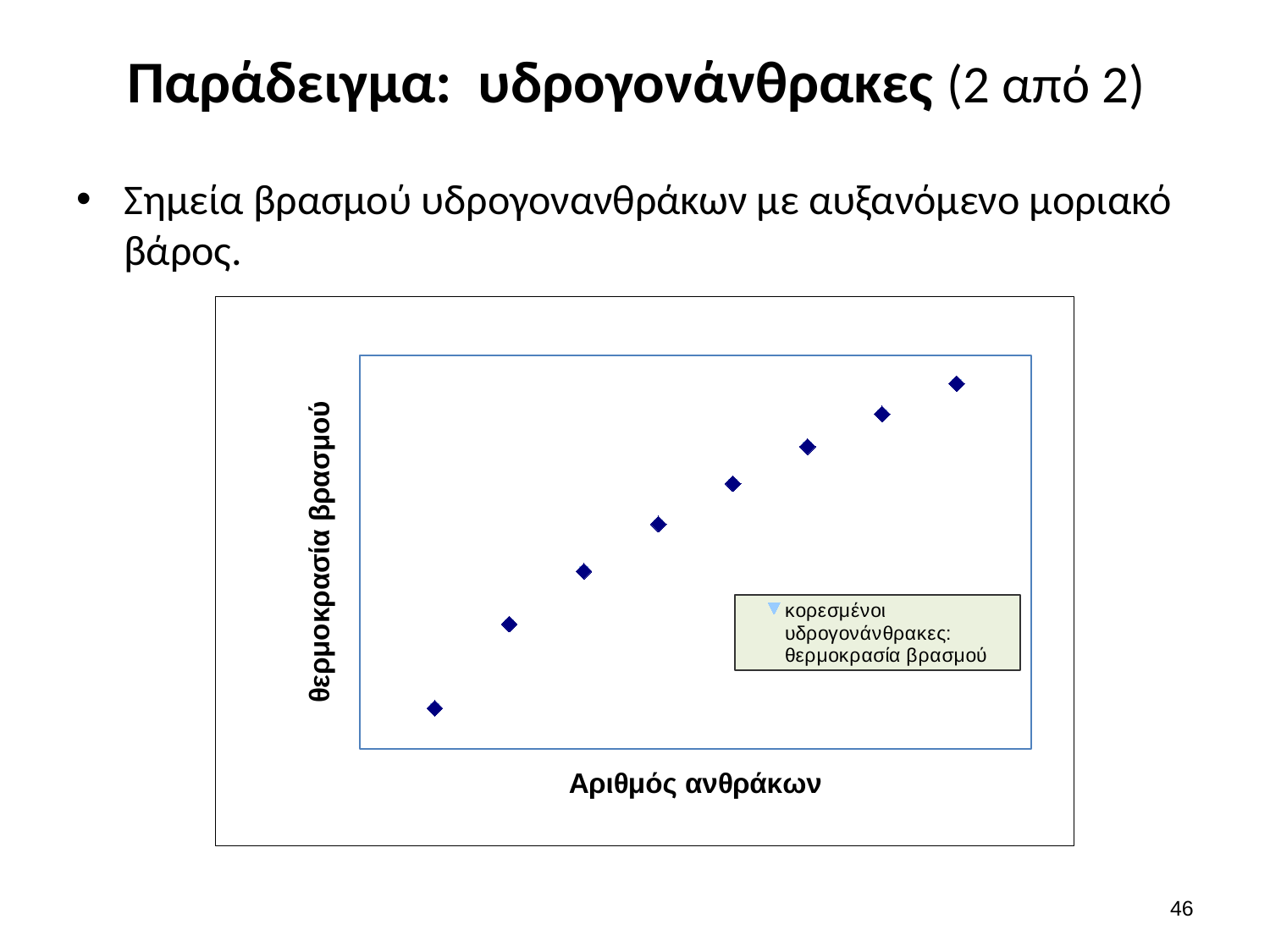
How many data points are plotted in the chart? 8 What kind of chart is shown on the slide? scatter plot Is the highest plotted boiling temperature at the leftmost or the rightmost point of the chart? rightmost Do the plotted values rise or fall as the number of carbons increases along the x axis? rise What series name does the chart legend show? κορεσμένοι υδρογονάνθρακες: θερμοκρασία βρασμού What is the title of the x axis of the chart? Αριθμός ανθράκων Is the lowest plotted boiling temperature at the leftmost or the rightmost point of the chart? leftmost How many series does the chart legend list? 1